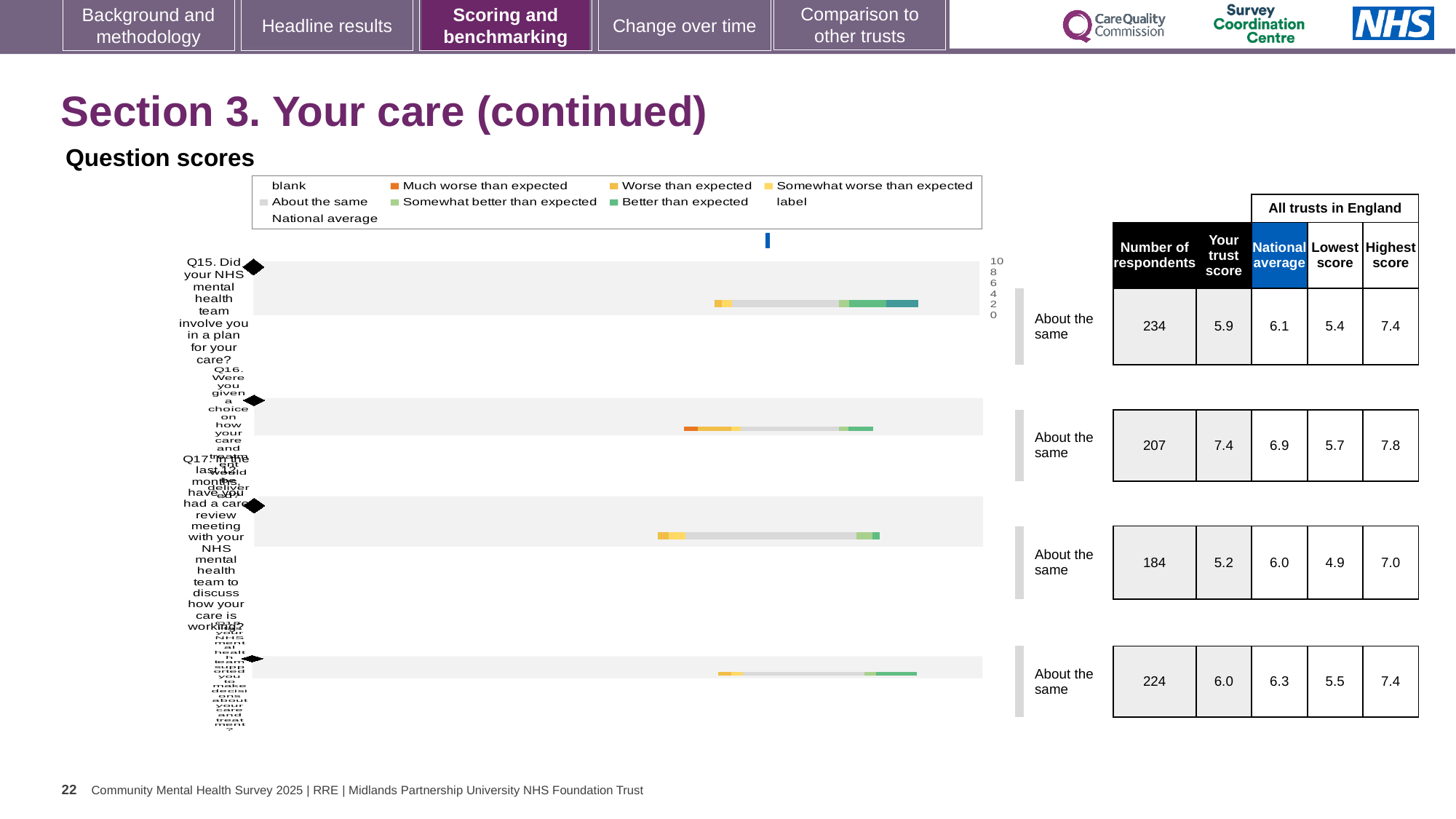
What kind of chart is shown under 'Question scores'? bar chart For Q15, which is larger: the trust score or the national average? National average What is the highest score across all trusts in England for Q16? 7.8 Which question has the highest trust score? Q16 How many respondents answered Q17 (care review meeting in the last 12 months)? 184 What is the difference between the trust score and the national average for Q16? 0.5 What colour does the legend use for 'Much worse than expected'? Orange Which question has the lowest trust score? Q17 What is the national average for Q16? 6.9 What benchmark category is shown for Q17? About the same How many question bars are plotted in the chart? 4 What is the trust score for Q15 (involving you in a plan for your care)? 5.9